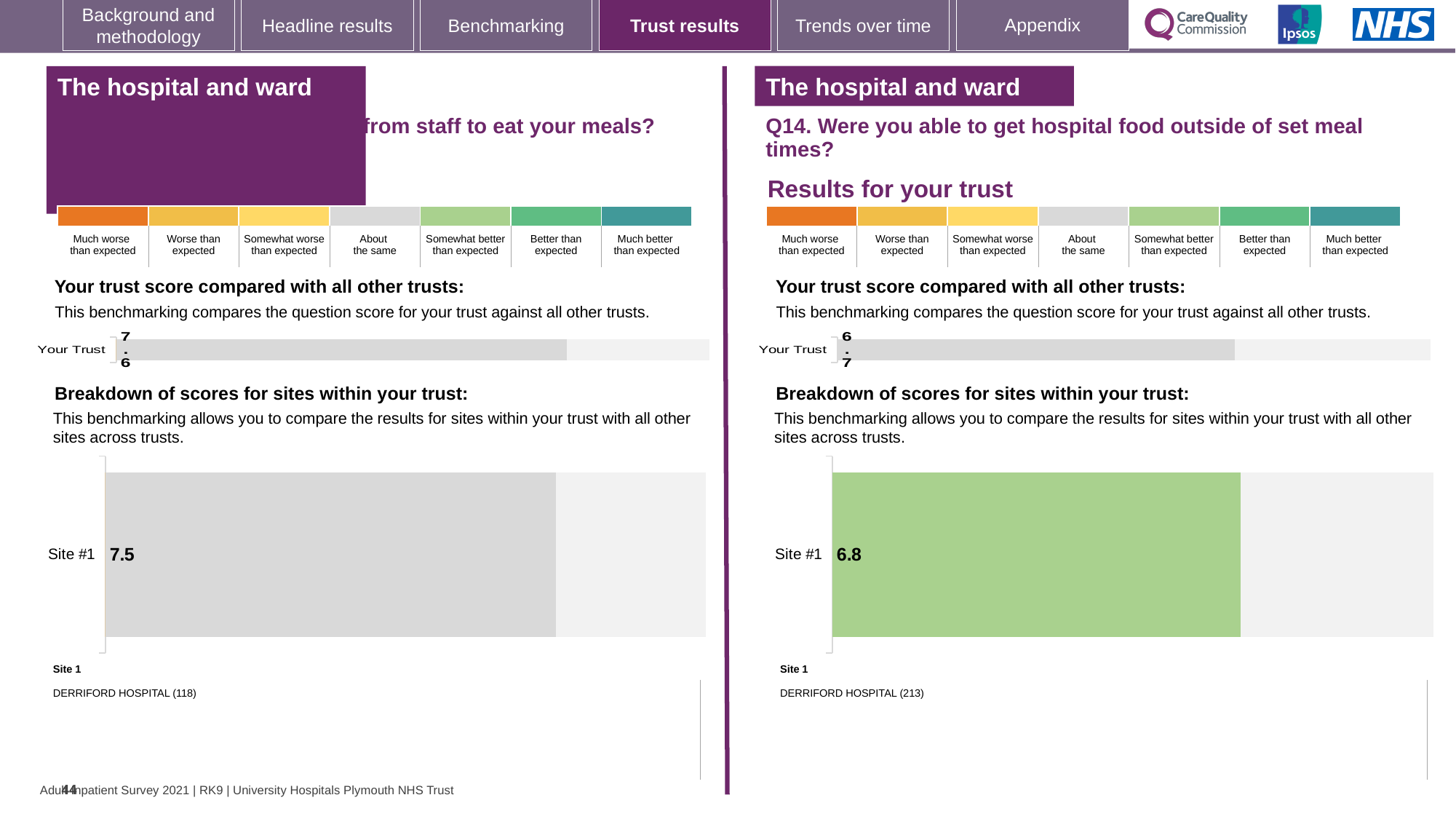
On the right-hand side for Q14, what is the difference between the Site #1 score and the Your Trust score? 0.1 What type of chart is used to show the Site #1 score on the right-hand side for Q14? Bar chart On the right-hand chart for Q14, what is the score shown for Site #1? 6.8 According to the colour key, what does the green colour of the Site #1 bar on the right-hand Q14 chart indicate? Somewhat better than expected On the left-hand side, what is the difference between the Your Trust score and the Site #1 score? 0.1 Which Site #1 score is larger: the one on the left-hand site breakdown chart or the one on the right-hand site breakdown chart for Q14? The left-hand chart (7.5) On the left-hand 'Your trust score compared with all other trusts' chart, what is the value shown for Your Trust? 7.6 On the right-hand 'Your trust score compared with all other trusts' chart for Q14, what is the value shown for Your Trust? 6.7 Which site name is listed under Site 1 on the right-hand side for Q14? DERRIFORD HOSPITAL (213) How many sites are shown in the right-hand 'Breakdown of scores for sites within your trust' chart for Q14? 1 On the left-hand 'Breakdown of scores for sites within your trust' chart, what is the score shown for Site #1? 7.5